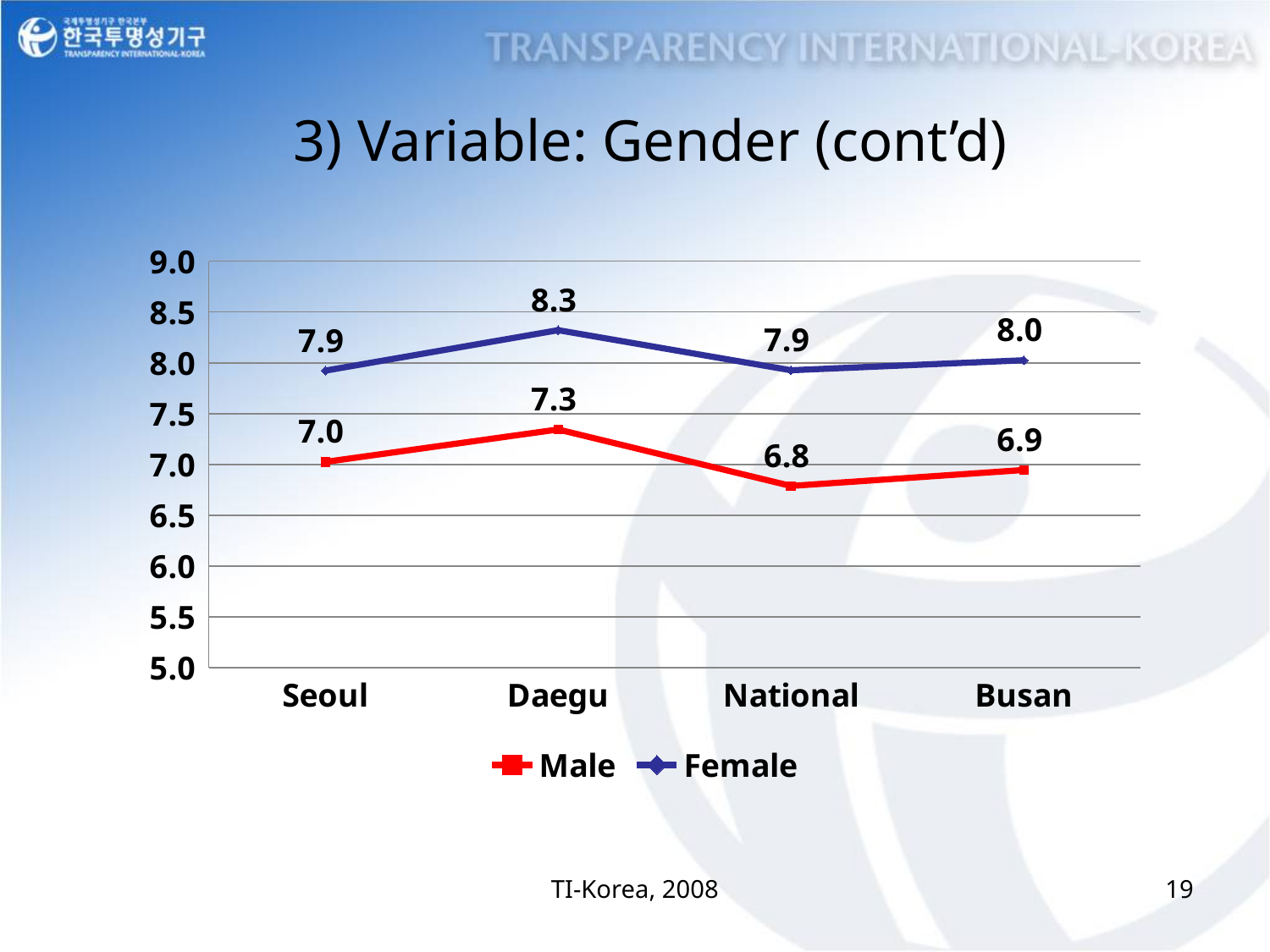
Which is larger, the Female value for Seoul or the Female value for Busan? Busan What is the difference between the Female and Male values for Daegu? 1.0 What is the Male value for Daegu? 7.3 Which category has the highest Female value? Daegu Which colour is used for the Female series? Blue What is the difference between the Male values for Daegu and National? 0.5 What kind of chart is shown on the slide? Line chart Which category has the lowest Male value? National How many series does the legend list? 2 How many categories are shown on the x axis? 4 What is the Male value for National? 6.8 What is the Female value for Busan? 8.0